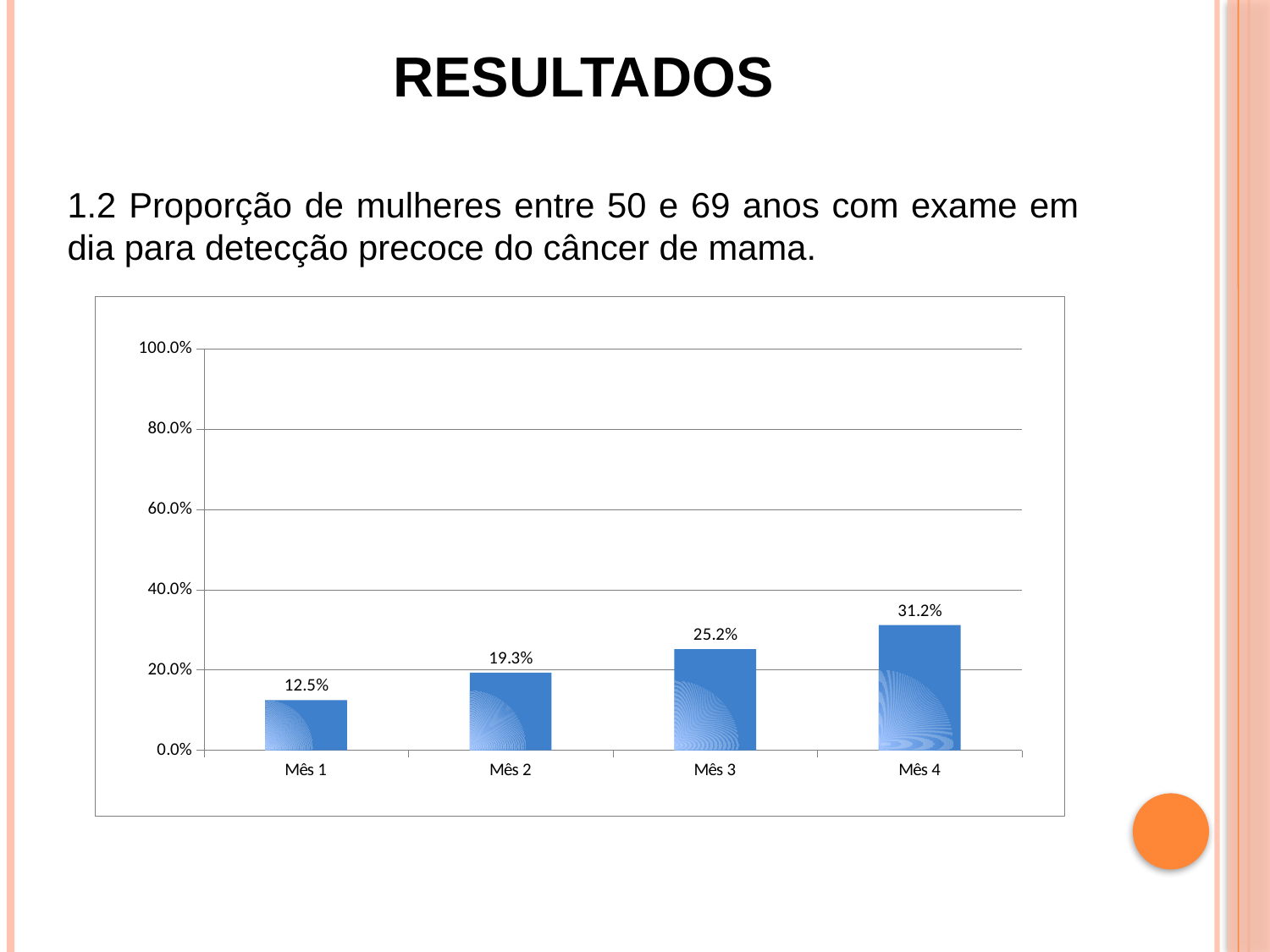
Is the value for Mês 4 greater or less than 40.0%? less How many months are shown on the x axis? 4 Which month has the highest value? Mês 4 What is the value for Mês 3? 25.2% Which is larger, the value for Mês 2 or the value for Mês 3? Mês 3 Which month has the lowest value? Mês 1 What kind of chart is shown on the slide? bar chart What is the difference between the values for Mês 2 and Mês 1? 6.8% Do the values rise or fall from Mês 1 to Mês 4? rise What is the value for Mês 4? 31.2% What is the difference between the values for Mês 4 and Mês 1? 18.7% What is the value for Mês 1? 12.5%